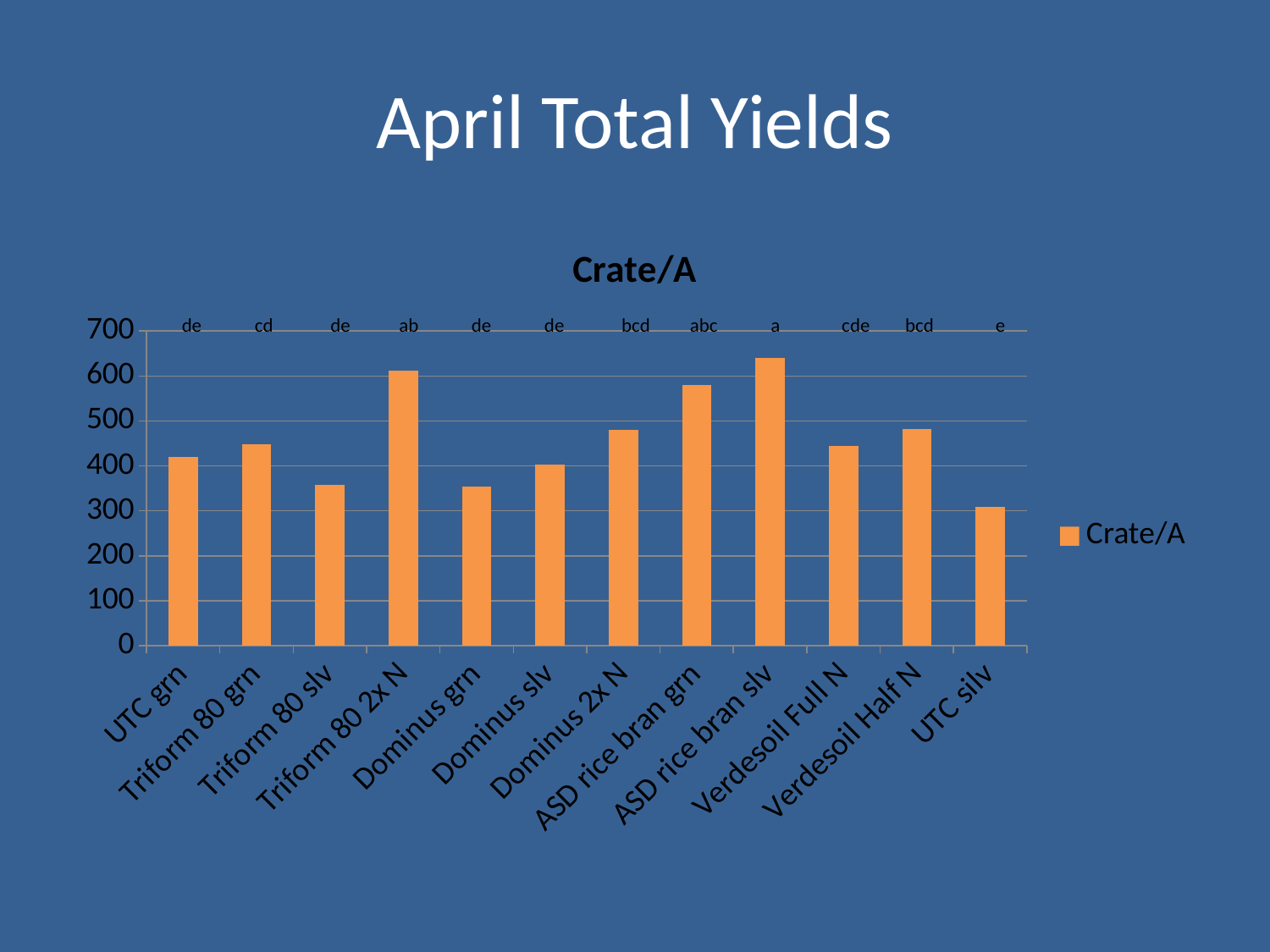
How many categories are plotted on the x axis? 12 What kind of chart is shown on the slide? bar chart What is the title of the chart? Crate/A Which letter label appears above the ASD rice bran slv bar? a Is the value for ASD rice bran grn greater or less than 500? greater Which is larger, the value for Triform 80 2x N or the value for Dominus 2x N? Triform 80 2x N Which category has the lowest Crate/A value? UTC silv Which category has the highest Crate/A value? ASD rice bran slv How many series does the legend list? 1 Is the value for Dominus grn greater or less than 400? less Is the value for Triform 80 2x N greater or less than 600? greater